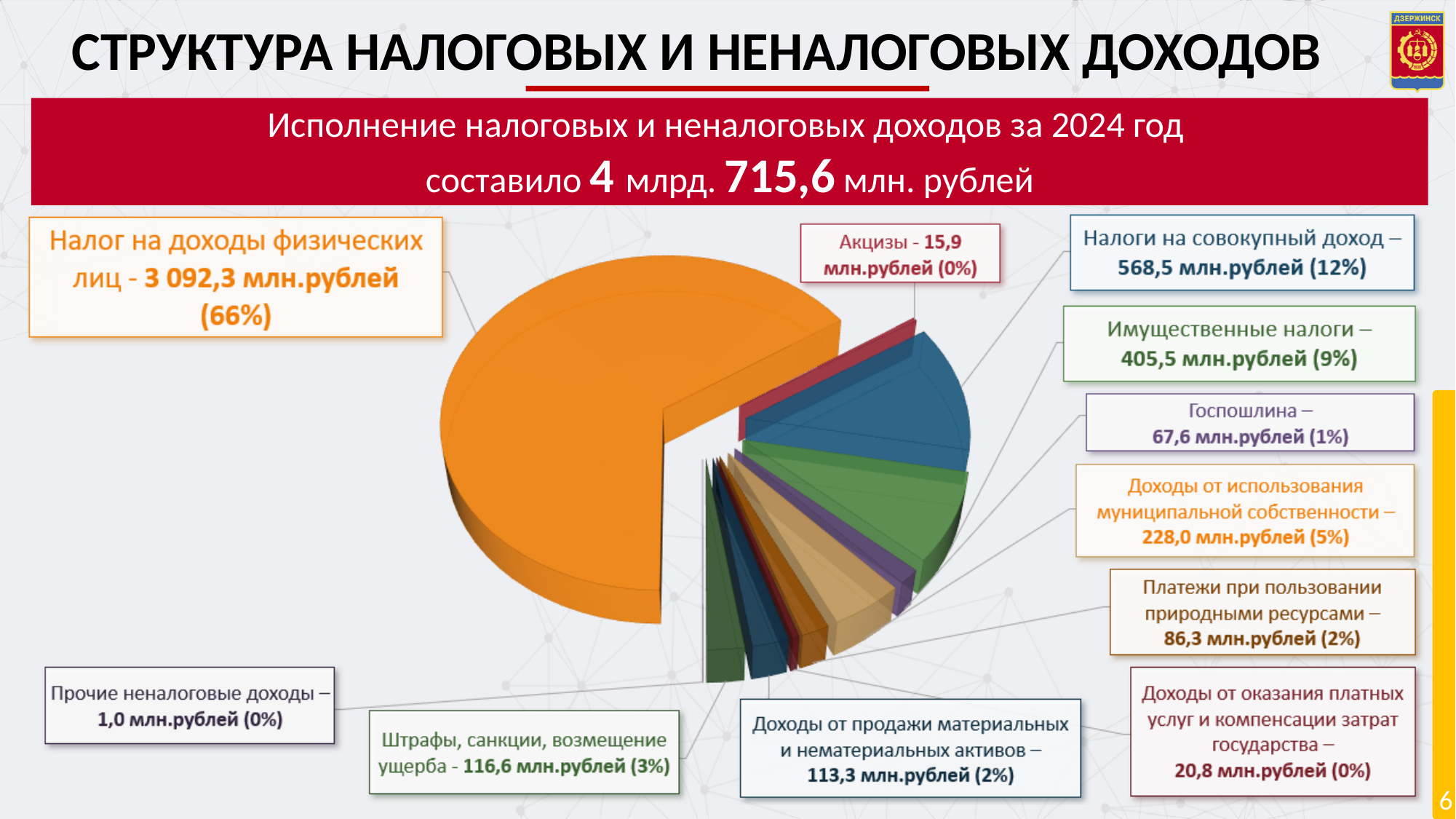
Which is larger: Штрафы, санкции, возмещение ущерба or Платежи при пользовании природными ресурсами? Штрафы, санкции, возмещение ущерба What is the value for Налог на доходы физических лиц? 3 092,3 млн.рублей What kind of chart is shown on the slide? Pie chart What total amount of tax and non-tax revenue for 2024 is stated on the slide? 4 млрд. 715,6 млн. рублей Which category has the smallest value? Прочие неналоговые доходы What is the value for Госпошлина? 67,6 млн.рублей What share of the pie does Доходы от использования муниципальной собственности represent? 5% How many categories (slices) does the pie chart have? 11 What is the value for Налоги на совокупный доход? 568,5 млн.рублей Which category has the largest slice of the pie? Налог на доходы физических лиц What share of the pie does Имущественные налоги represent? 9% What is the difference between Налоги на совокупный доход and Имущественные налоги? 163,0 млн.рублей